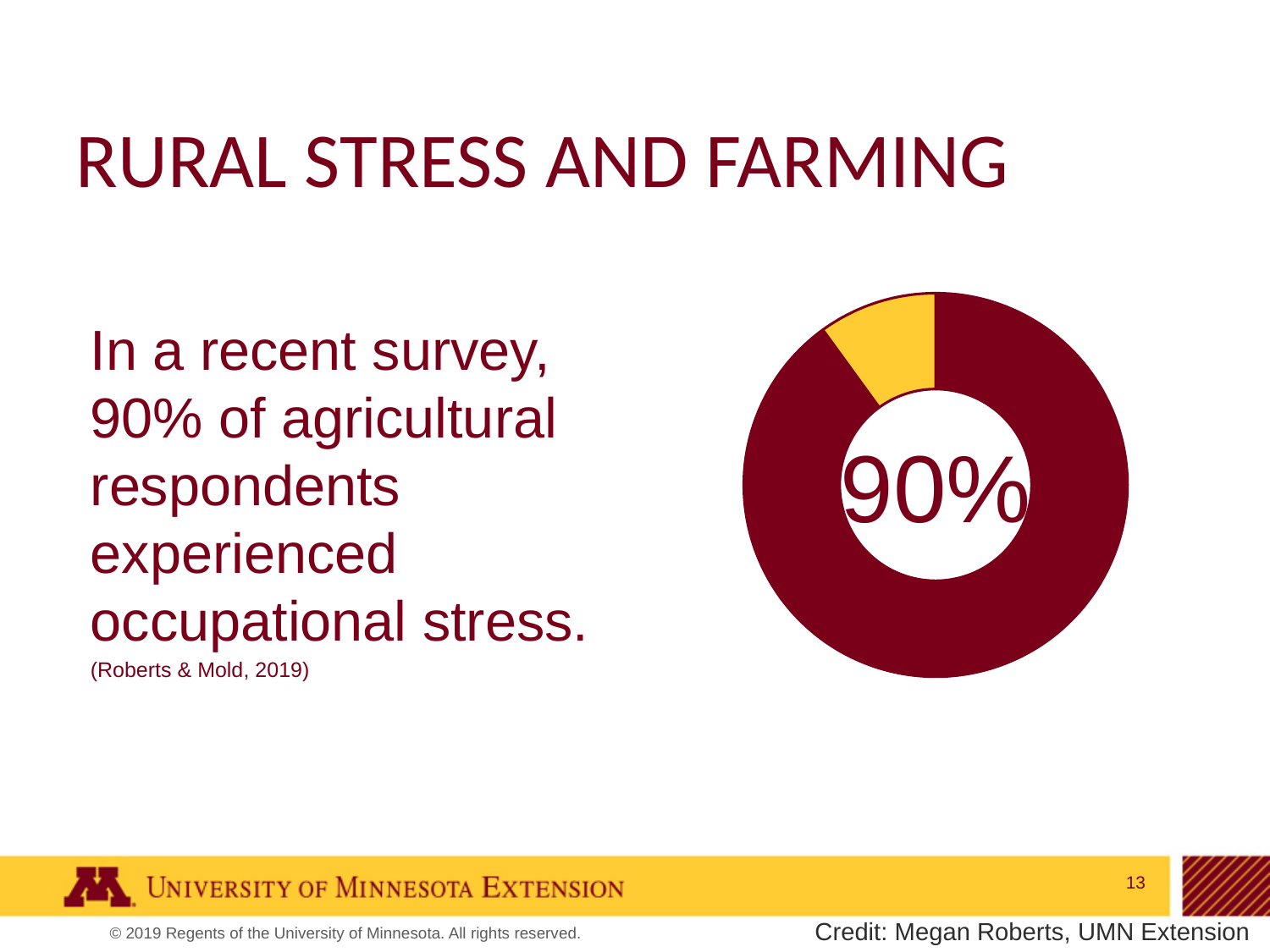
Does the doughnut chart include a legend? No What share of the doughnut chart does the dark red (maroon) slice represent? 90% What share of the doughnut chart does the yellow slice represent? 10% What percentage is printed in the centre of the doughnut chart? 90% What kind of chart is shown on the slide? doughnut chart Is the share of the dark red slice in the doughnut chart greater or less than 50%? greater Which slice of the doughnut chart is larger, the dark red one or the yellow one? the dark red one How many slices does the doughnut chart have? 2 What colour is the smaller slice of the doughnut chart? yellow